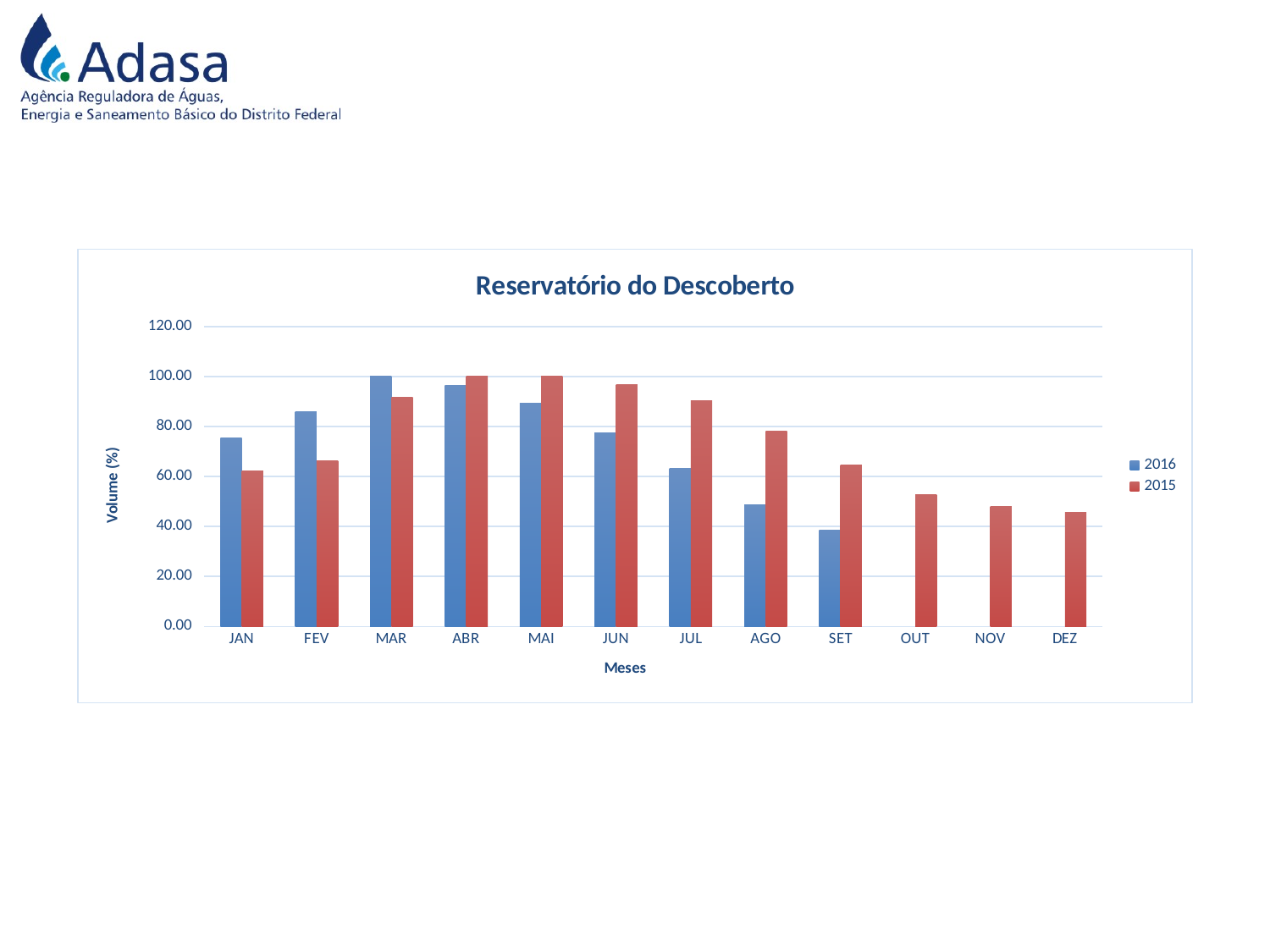
In JAN, which series has the larger value, 2016 or 2015? 2016 Is the value for 2016 in JAN greater or less than 60.00? greater What is the title of the chart? Reservatório do Descoberto Which month has the highest value for the 2016 series? MAR Is the value for 2016 in SET greater or less than 40.00? less What is the label of the vertical axis? Volume (%) Do the 2016 values rise or fall from MAR to SET? fall Is the value for 2015 in OUT greater or less than 60.00? less In JUL, which series has the larger value, 2016 or 2015? 2015 How many months are shown on the x axis? 12 What kind of chart is shown on the slide? Bar chart How many series does the legend list? 2